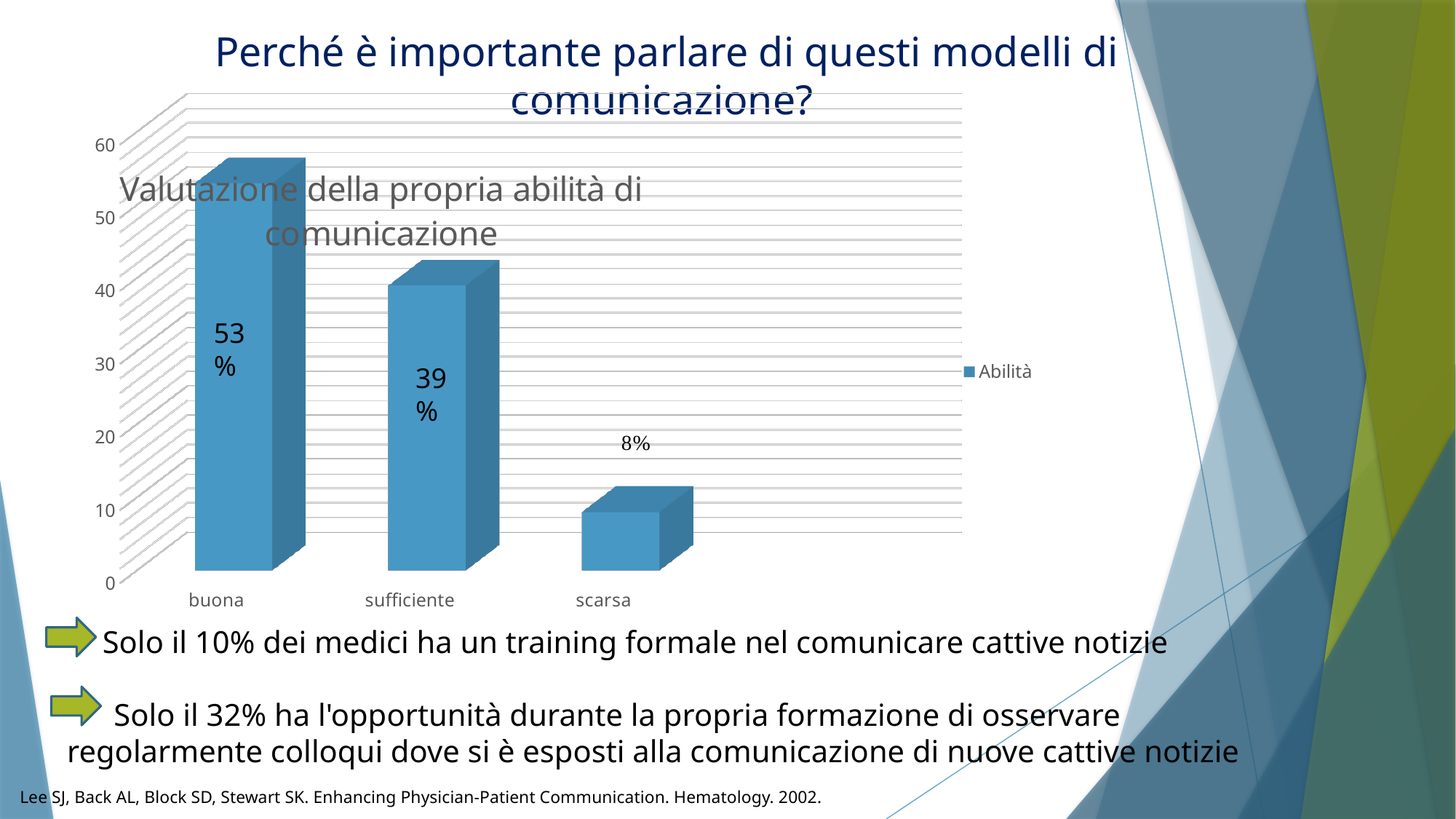
What is the value for 'sufficiente'? 39% Which is larger, the value for 'sufficiente' or the value for 'scarsa'? sufficiente Which category has the highest value? buona What is the difference between the values for 'sufficiente' and 'scarsa'? 31% What is the name of the series shown in the legend? Abilità What kind of chart is shown on the slide? bar chart How many series does the legend list? 1 What is the difference between the values for 'buona' and 'sufficiente'? 14% What is the value for 'scarsa'? 8% What is the value for 'buona'? 53% How many categories are shown on the x axis? 3 Which category has the lowest value? scarsa